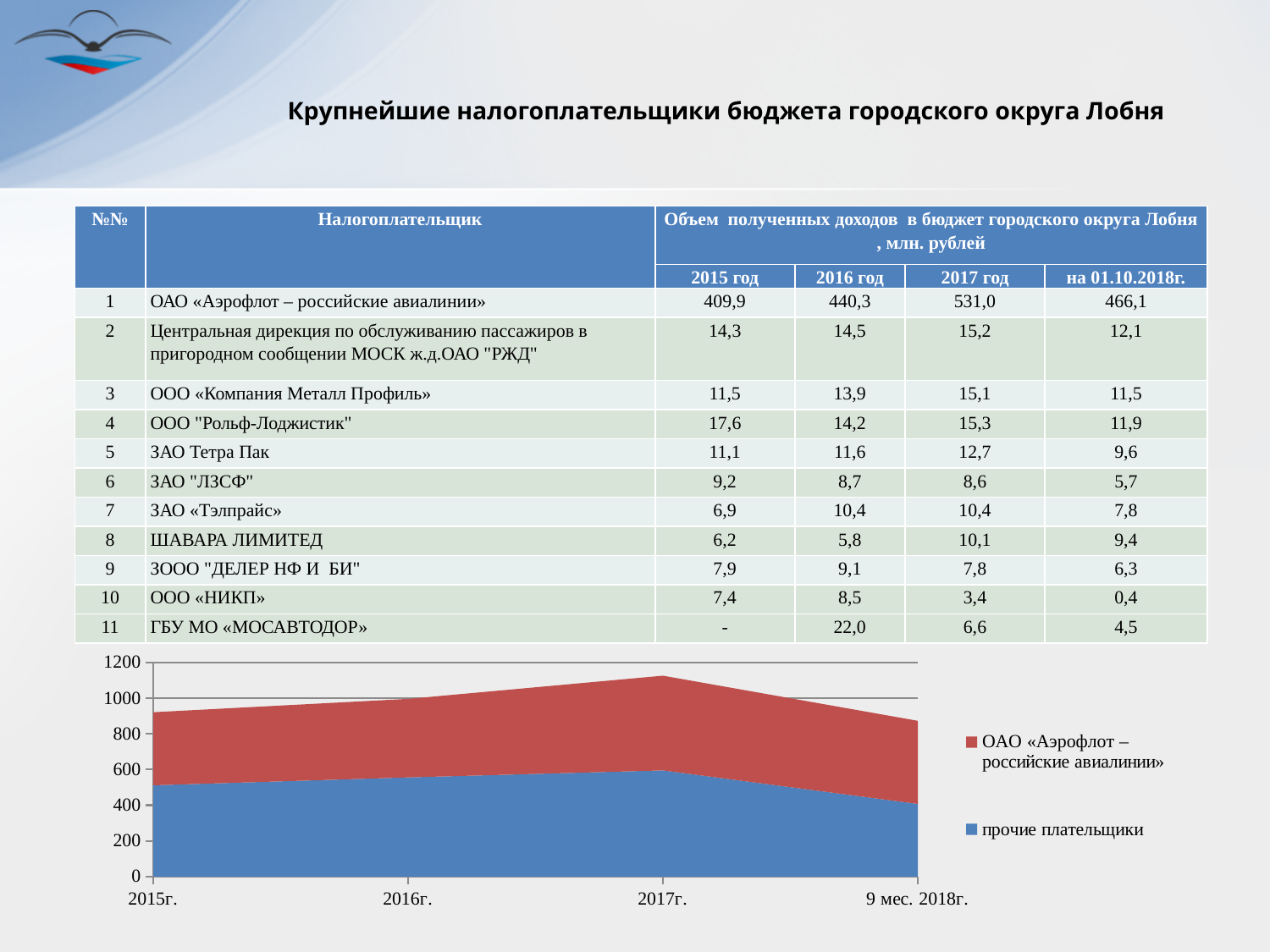
Is the value for прочие плательщики in 2015г. greater or less than 400? greater Which series is shown in red in the chart? ОАО «Аэрофлот – российские авиалинии» What kind of chart is shown at the bottom of the slide? Area chart Is the combined total of both series in 2015г. greater or less than 1000? less Is the combined total of both series larger in 2017г. or in 2015г.? 2017г. How many series does the chart legend list? 2 Which series is shown in blue in the chart? прочие плательщики How many time points are plotted along the x axis of the chart? 4 Is the combined total of both series in 2017г. greater or less than 1000? greater How does the combined total of both series change from 2015г. to 2017г.? It rises In which year does the combined total of both series reach its highest point? 2017г.